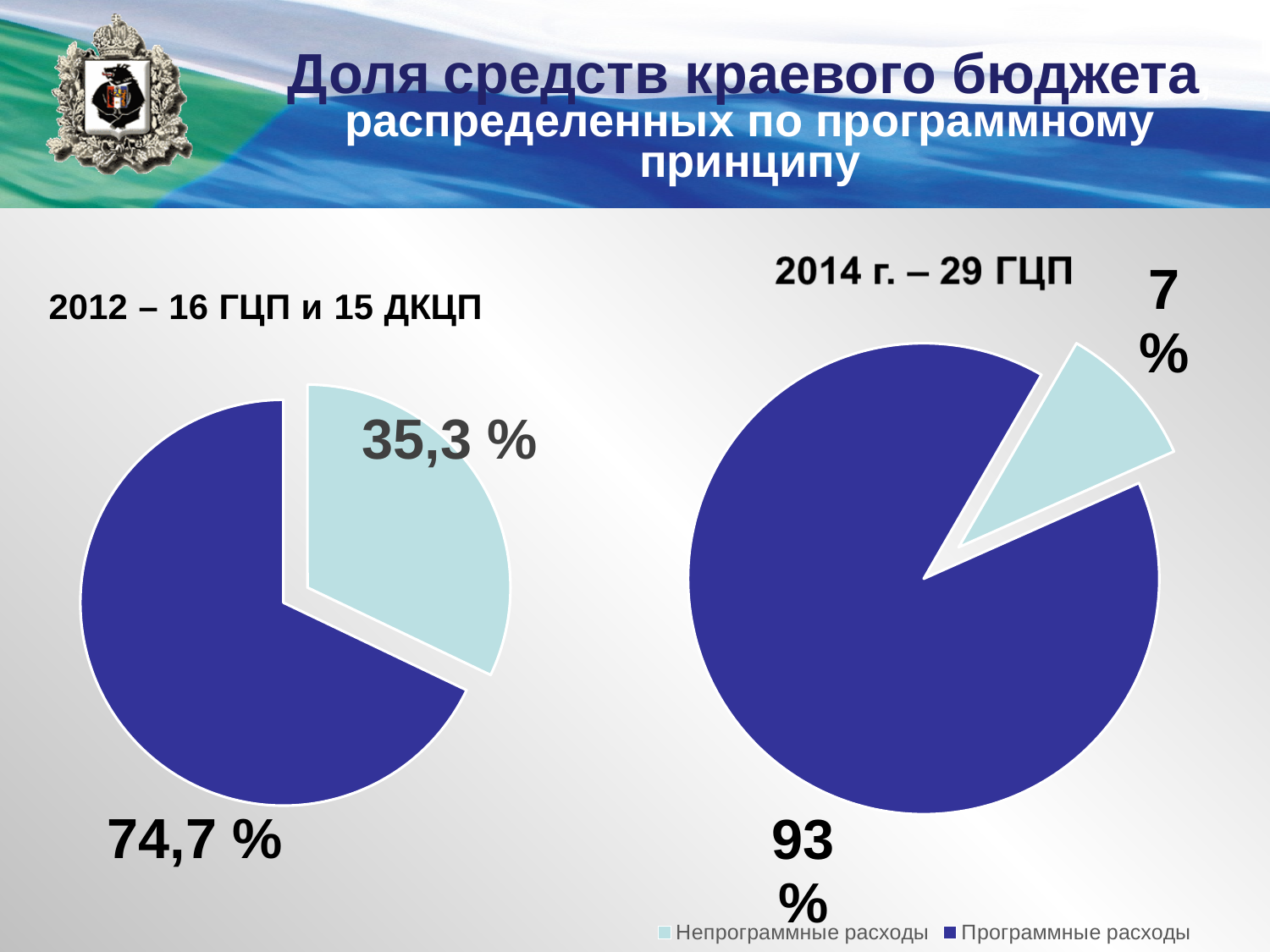
In the pie chart titled "2012 – 16 ГЦП и 15 ДКЦП", what value is shown for Непрограммные расходы? 35,3 % In the pie chart titled "2014 г. – 29 ГЦП", what value is shown for Программные расходы? 93 % In the pie chart titled "2014 г. – 29 ГЦП", what is the difference between the Программные расходы and Непрограммные расходы values? 86 % According to the legend, which colour represents Непрограммные расходы? light blue In the pie chart titled "2012 – 16 ГЦП и 15 ДКЦП", which category has the largest slice? Программные расходы In the pie chart titled "2014 г. – 29 ГЦП", which is larger: Программные расходы or Непрограммные расходы? Программные расходы In the pie chart titled "2012 – 16 ГЦП и 15 ДКЦП", what value is shown for Программные расходы? 74,7 % In the pie chart titled "2014 г. – 29 ГЦП", what value is shown for Непрограммные расходы? 7 % How many slices does the pie chart titled "2012 – 16 ГЦП и 15 ДКЦП" have? 2 What kind of chart is the chart titled "2014 г. – 29 ГЦП"? pie chart In the pie chart titled "2014 г. – 29 ГЦП", which category has the smallest slice? Непрограммные расходы How many entries does the legend at the bottom of the slide list? 2